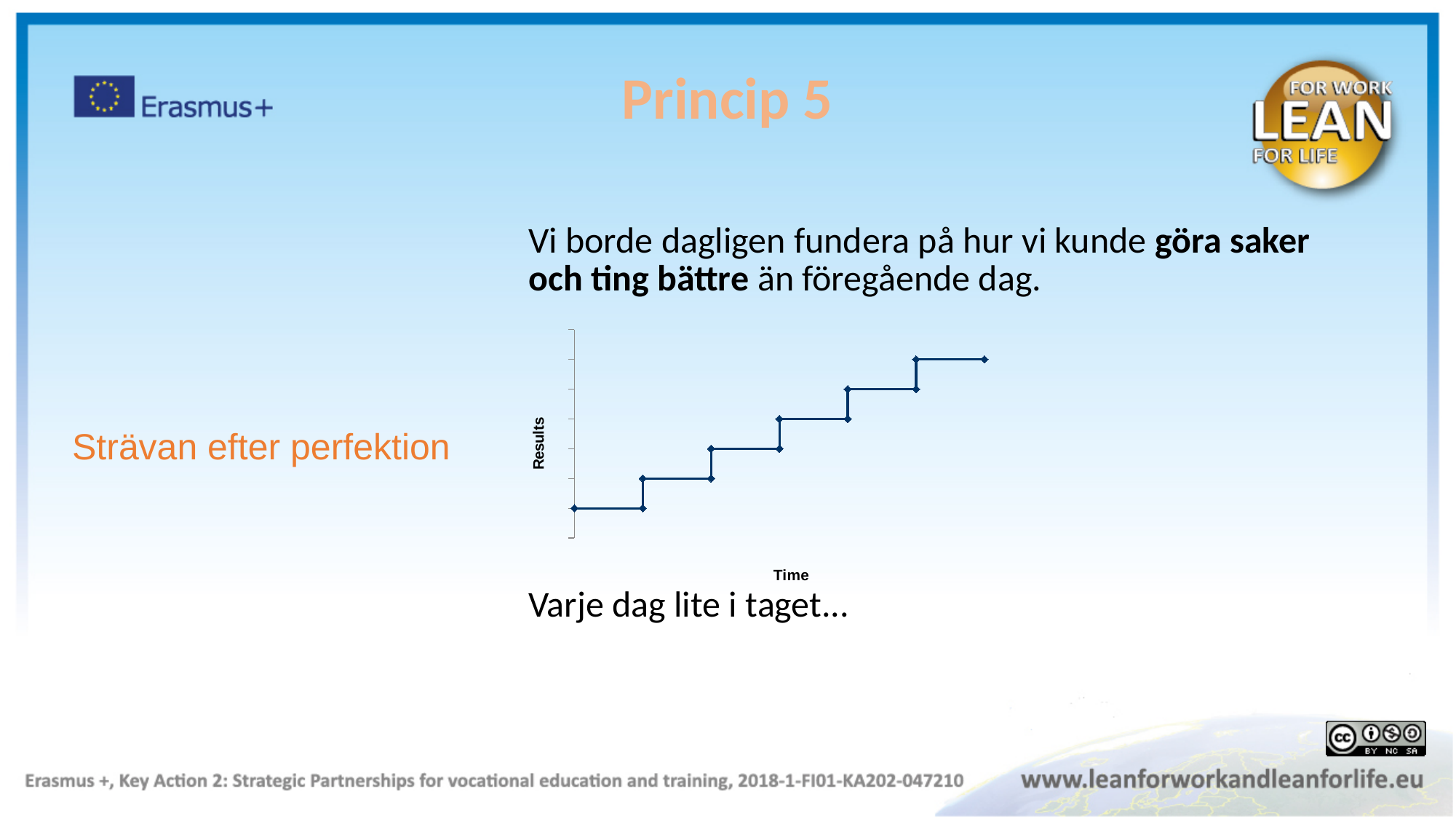
What is the label of the vertical axis of the chart? Results What is the label of the horizontal axis of the chart? Time Do the values in the chart rise or fall along the x axis? rise What kind of chart is shown on the slide? line chart Is the value at the right end of the line higher or lower than the value at the left end? higher Where along the Time axis is the highest point of the line located, at the left or the right end? right end Does the line in the chart ever decrease as time goes on? No Where along the Time axis is the lowest point of the line located, at the left or the right end? left end How many data point markers are plotted on the line in the chart? 12 How many upward steps does the line in the chart make? 5